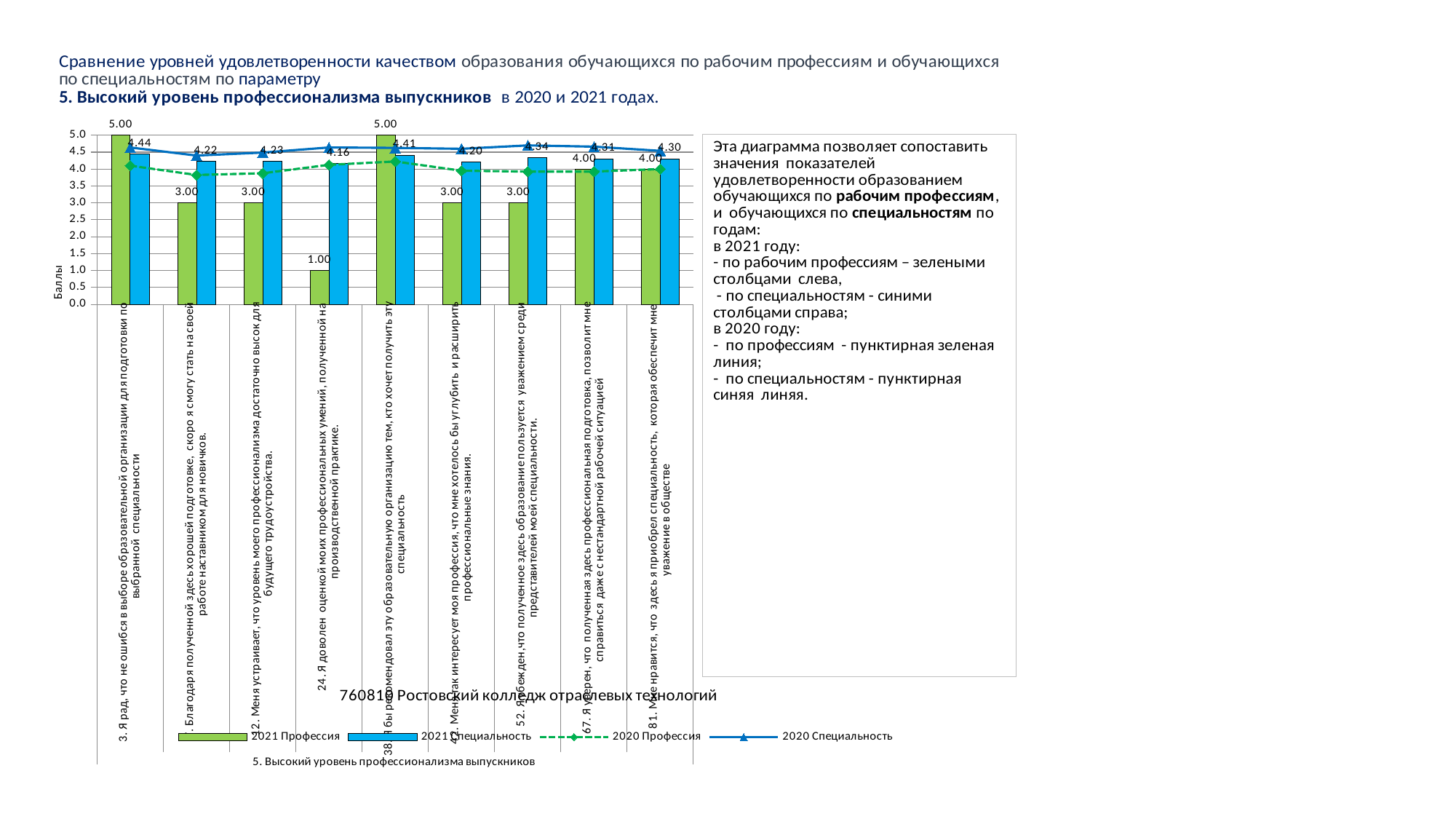
Which statement has the lowest 2021 Профессия value? 24. Я доволен оценкой моих профессиональных умений, полученной на производственной практике What is the 2021 Специальность value for statement 81 (Мне нравится, что здесь я приобрел специальность, которая обеспечит мне уважение в обществе)? 4.30 For statement 67, which is larger: the 2021 Профессия value or the 2021 Специальность value? 2021 Специальность What is the 2021 Специальность value for statement 3 (Я рад, что не ошибся в выборе образовательной организации)? 4.44 For statement 24, what is the difference between the 2021 Специальность value and the 2021 Профессия value? 3.16 Is the 2020 Специальность value for statement 3 greater or less than 4.0? greater What kind of chart is shown on the slide? A bar chart combined with line series How many statement categories are plotted along the x axis? 9 How many series does the legend list? 4 Which statement has the highest 2021 Специальность value? 3. Я рад, что не ошибся в выборе образовательной организации для подготовки по выбранной специальности Which statement has the lowest 2021 Специальность value? 24. Я доволен оценкой моих профессиональных умений, полученной на производственной практике What is the 2021 Профессия value for statement 24 (Я доволен оценкой моих профессиональных умений, полученной на производственной практике)? 1.00